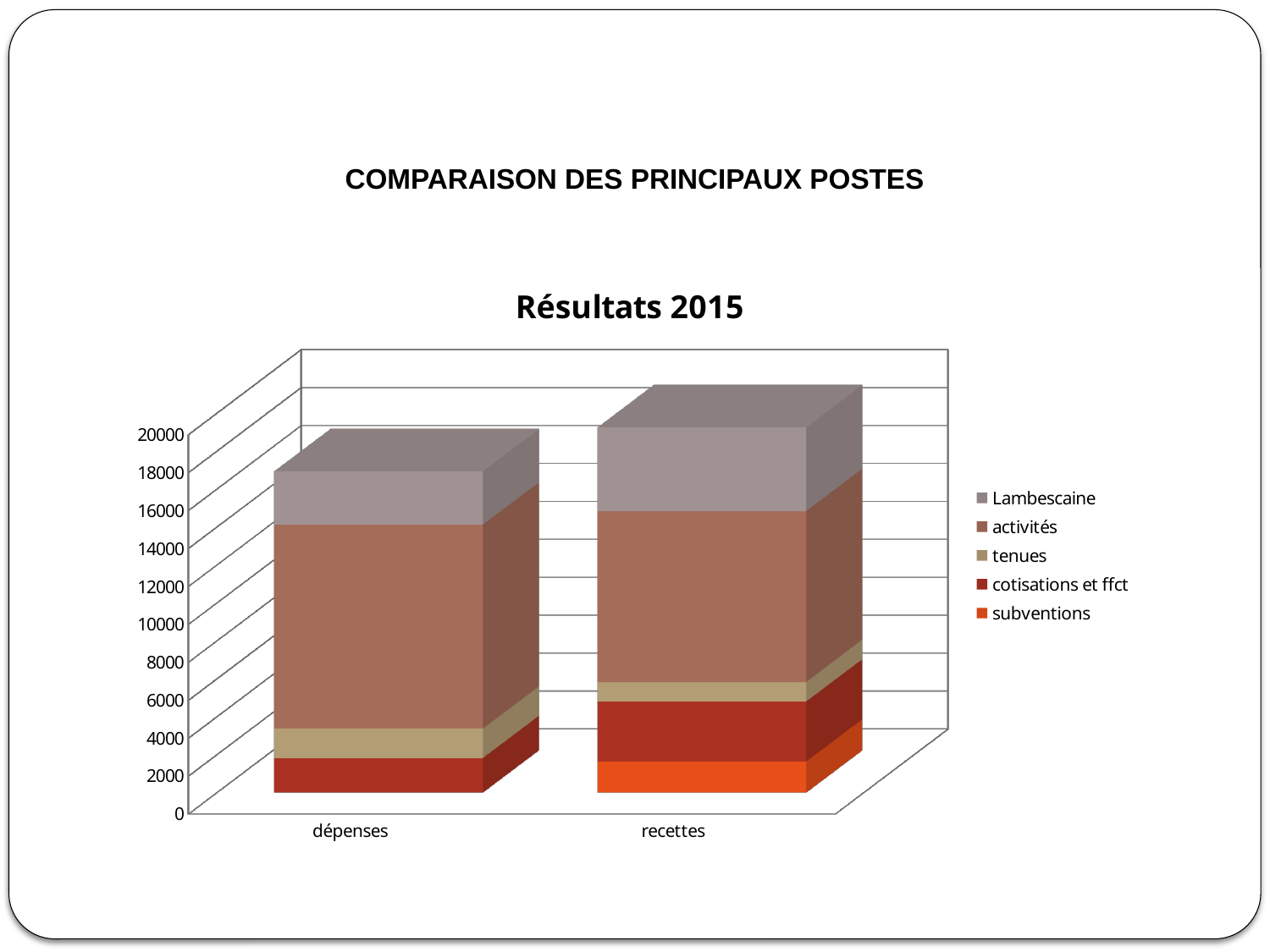
How many series does the legend of the chart list? 5 Do the total values rise or fall from dépenses to recettes along the x axis? rise Which series is listed first in the legend? Lambescaine Is the total value for dépenses greater or less than 20000? less What kind of chart is shown on the slide? Stacked bar chart Which category has the lowest total value? dépenses Which category has the highest total value? recettes Is the total value for dépenses greater or less than 14000? greater How many categories are shown on the x axis of the chart? 2 Is the total value for recettes greater or less than 16000? greater What is the title of the chart? Résultats 2015 Which category has the taller stacked bar, dépenses or recettes? recettes